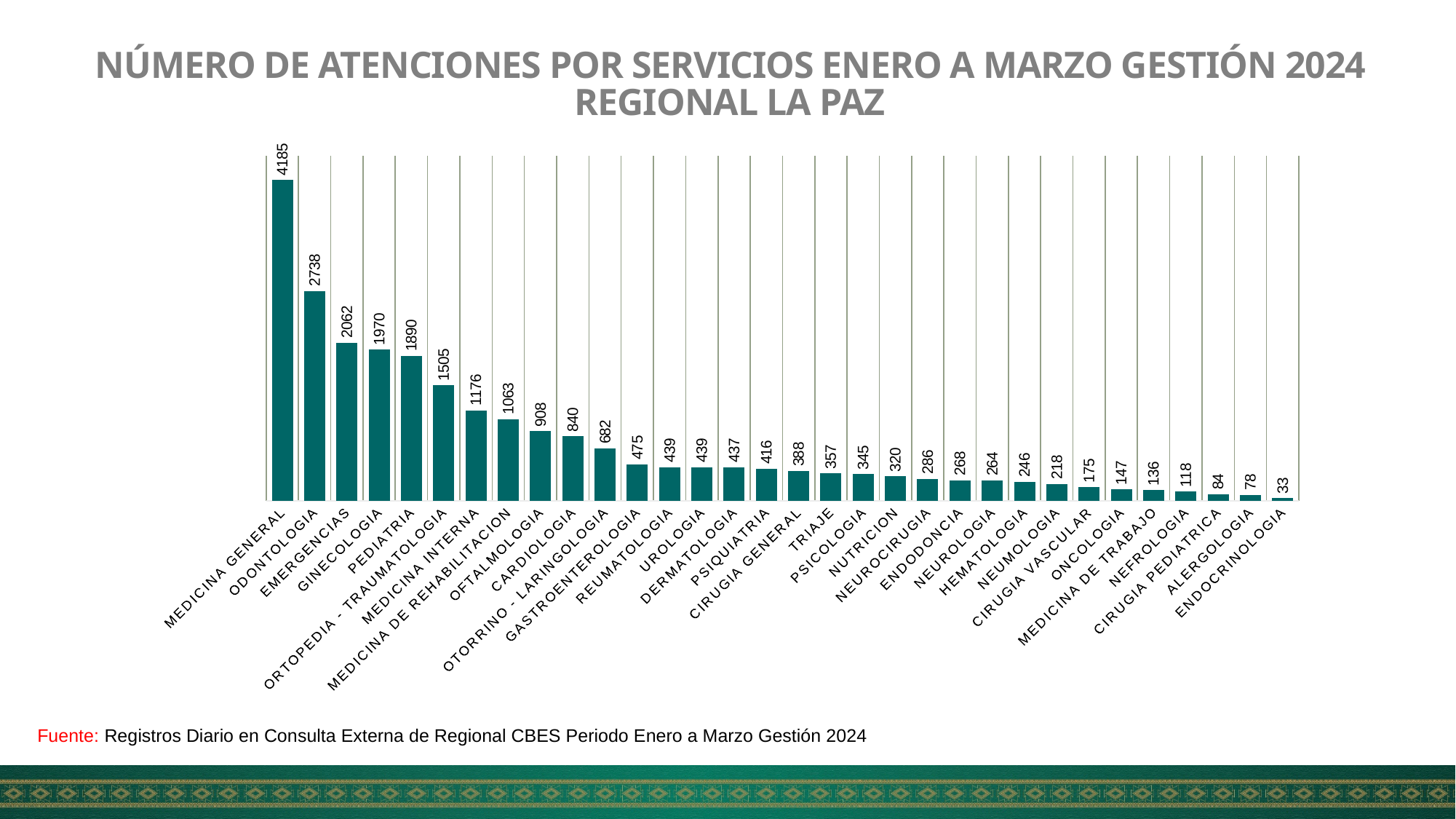
What is the value shown for PSIQUIATRIA? 416 What is the value shown for ONCOLOGIA? 147 Which service has the highest number of atenciones? MEDICINA GENERAL How many services (bars) are shown in the chart? 32 What is the difference between the values for ODONTOLOGIA and EMERGENCIAS? 676 What is the value shown for PEDIATRIA? 1890 Which service has the lowest number of atenciones? ENDOCRINOLOGIA Do the values rise or fall moving from left to right along the x axis? Fall Which has a larger value, GINECOLOGIA or ORTOPEDIA - TRAUMATOLOGIA? GINECOLOGIA What kind of chart is shown on the slide? Bar chart What is the number of atenciones for MEDICINA GENERAL? 4185 What is the difference between the values for CARDIOLOGIA and OFTALMOLOGIA? 68